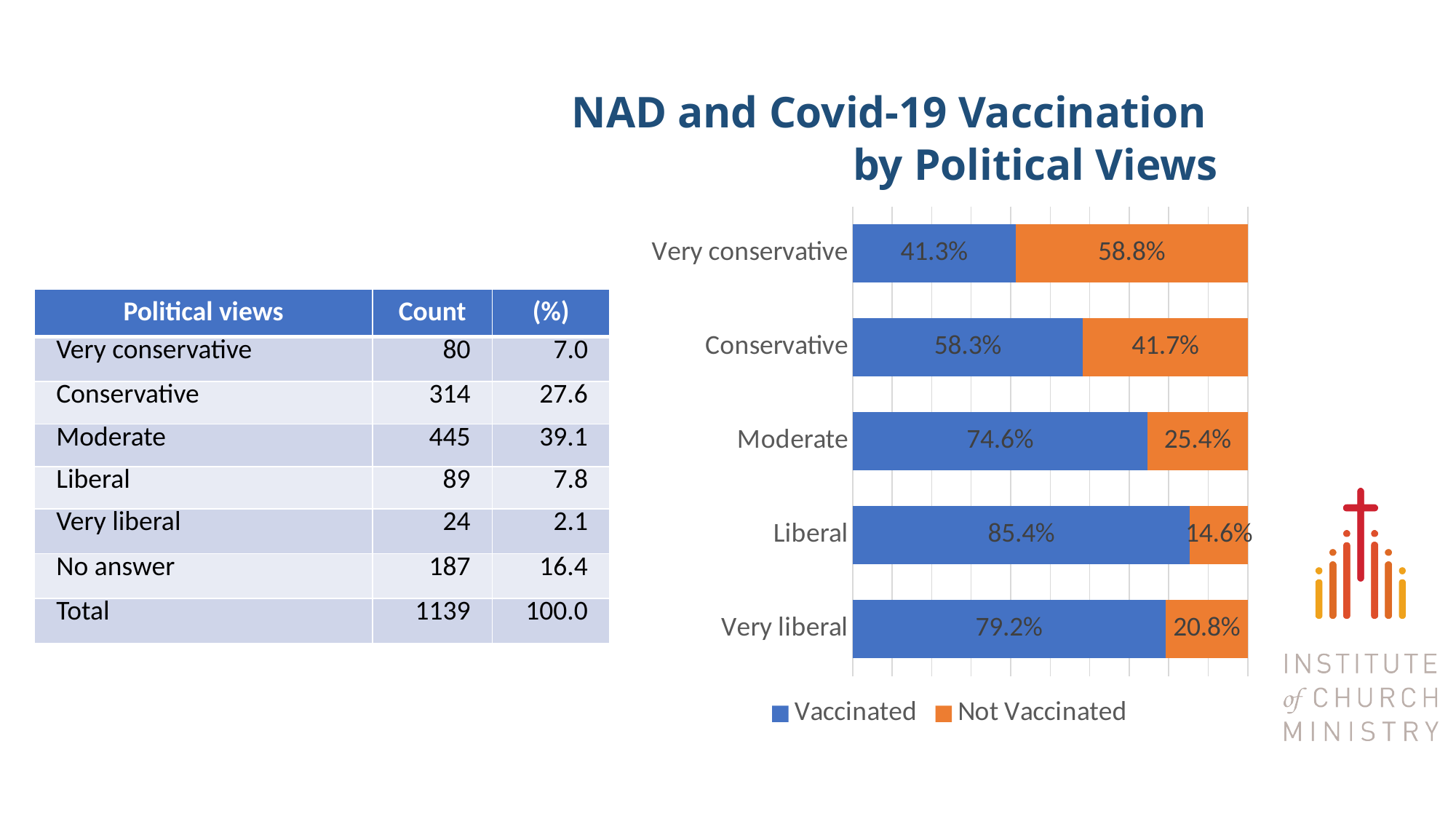
Which political view has the lowest Vaccinated percentage? Very conservative What is the Not Vaccinated value for Very conservative? 58.8% What kind of chart is shown on the slide? Stacked bar chart What is the Vaccinated value for Moderate? 74.6% Which colour represents the Vaccinated series? Blue Which political view has the highest Vaccinated percentage? Liberal What is the difference between the Vaccinated values for Liberal and Very liberal? 6.2 percentage points How many series does the legend list? 2 How many political view categories are shown in the chart? 5 For Conservative, how much larger is the Vaccinated value than the Not Vaccinated value? 16.6 percentage points Which has a larger Vaccinated value, Conservative or Very conservative? Conservative What is the Not Vaccinated value for Liberal? 14.6%